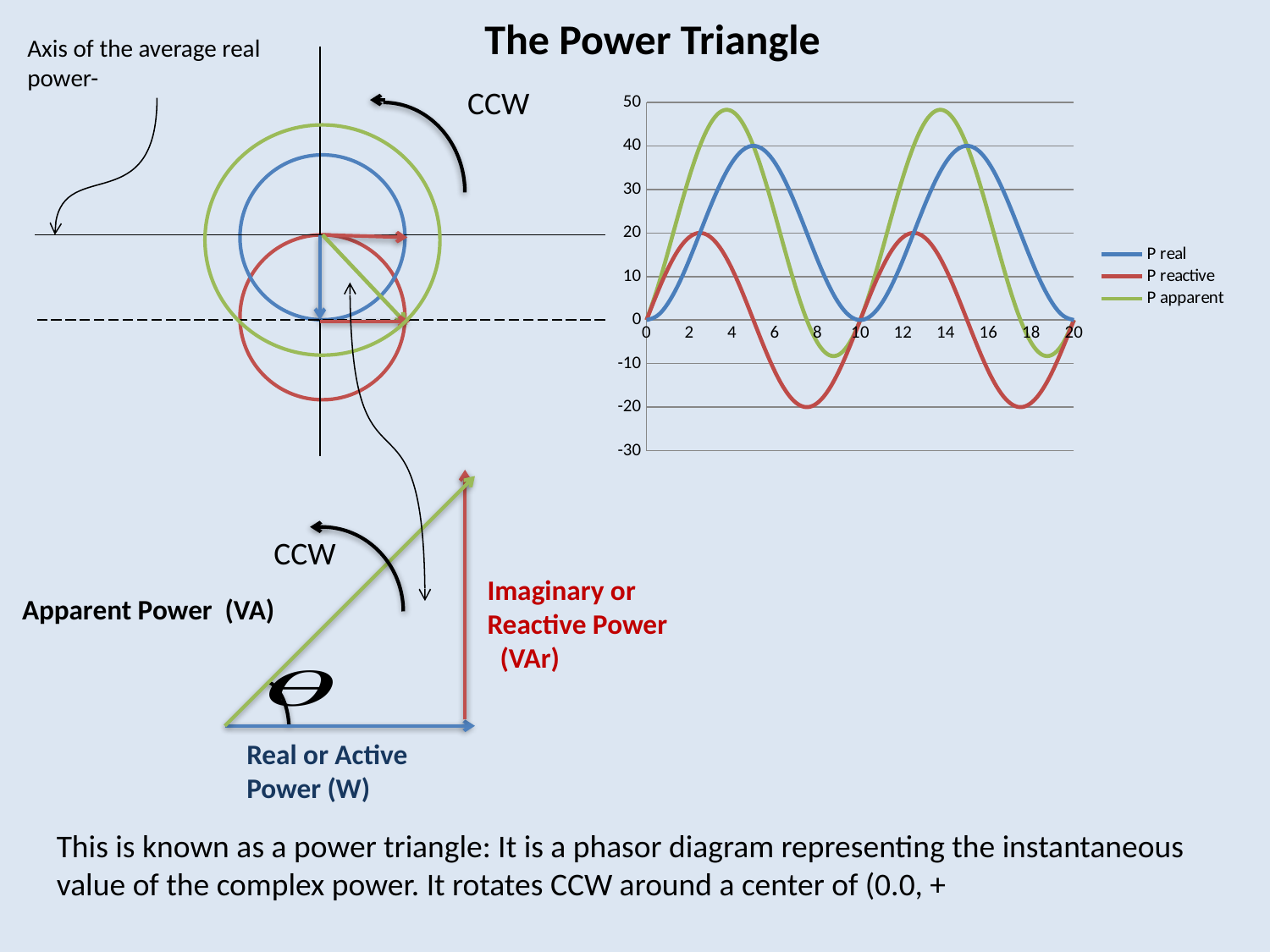
What kind of chart is shown on the slide? line chart Is the minimum value of P real greater or less than -10? greater What is the lowest value reached by the P reactive series? -20 At x = 4, which series has the larger value: P apparent or P real? P apparent What is the highest value shown on the chart's y axis? 50 Is the peak value of P reactive greater or less than 30? less Is the peak value of P apparent greater or less than 40? greater Which series reaches the highest peak value on the chart? P apparent What is the peak value reached by the P real series? 40 What are the series names listed in the chart's legend? P real, P reactive, P apparent Which series reaches the lowest value on the chart? P reactive How many series does the chart's legend list? 3